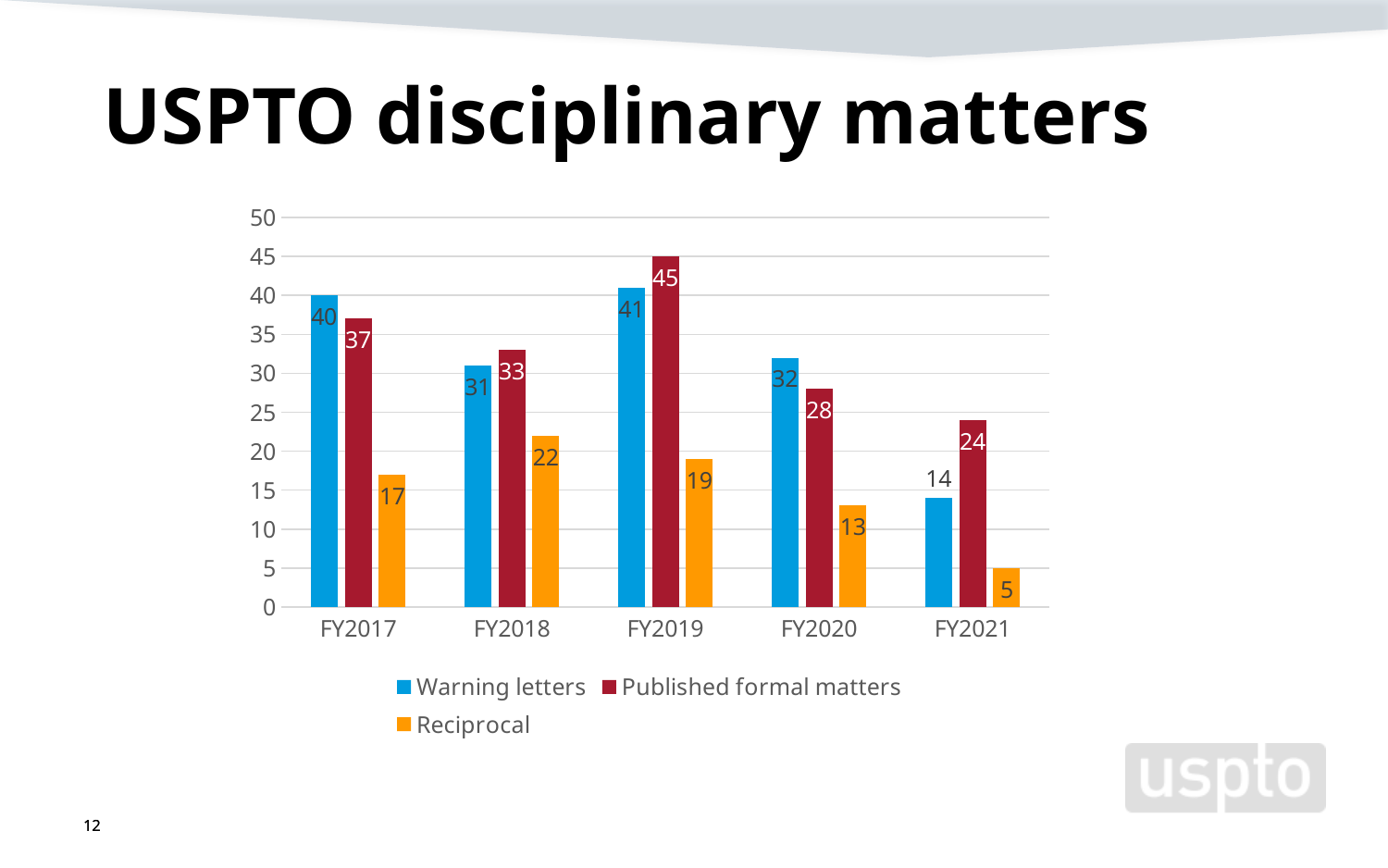
How many series does the legend list? 3 What is the difference between Warning letters and Published formal matters in FY2020? 4 Which is larger in FY2017: Warning letters or Published formal matters? Warning letters What is the value for Published formal matters in FY2021? 24 How many Warning letters were there in FY2019? 41 What is the Reciprocal value for FY2018? 22 What colour represents Reciprocal in the chart? Orange Do the Reciprocal values rise or fall from FY2018 to FY2021? Fall What kind of chart is shown on the slide? Bar chart How many fiscal years are shown on the x axis? 5 In which fiscal year was the Reciprocal value lowest? FY2021 In which fiscal year were Published formal matters highest? FY2019